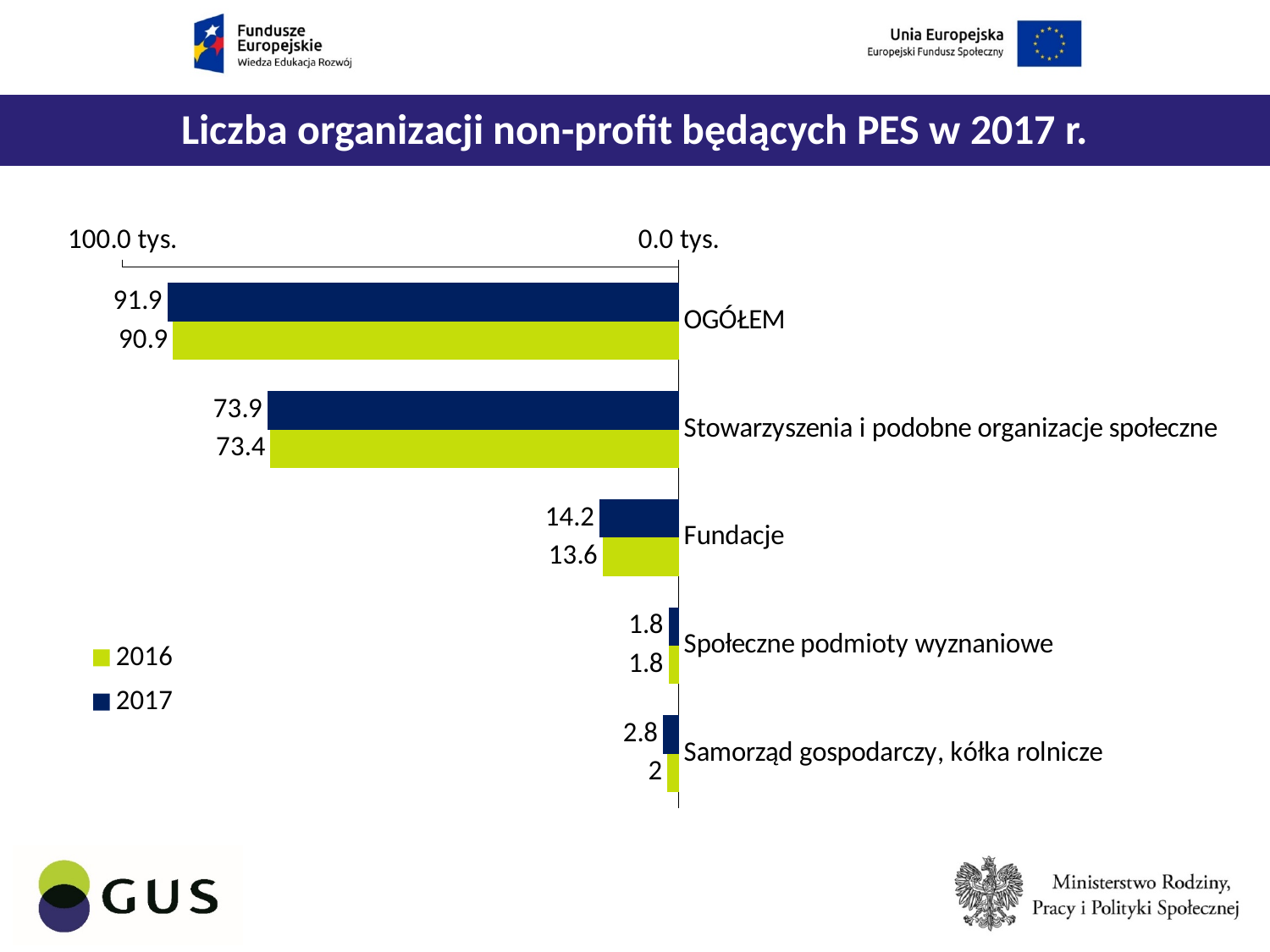
What is the 2017 value for OGÓŁEM? 91.9 What is the difference between the 2017 and 2016 values for OGÓŁEM? 1.0 Excluding OGÓŁEM, which category has the highest 2017 value? Stowarzyszenia i podobne organizacje społeczne What is the 2016 value for Samorząd gospodarczy, kółka rolnicze? 2 What is the 2017 value for Stowarzyszenia i podobne organizacje społeczne? 73.9 What kind of chart is shown on the slide? Bar chart What is the 2016 value for Fundacje? 13.6 How many categories are shown on the chart? 5 Which category has the lowest 2016 value? Społeczne podmioty wyznaniowe What is the difference between the 2017 and 2016 values for Fundacje? 0.6 How many series does the legend list? 2 Which is larger for Samorząd gospodarczy, kółka rolnicze: the 2016 value or the 2017 value? 2017